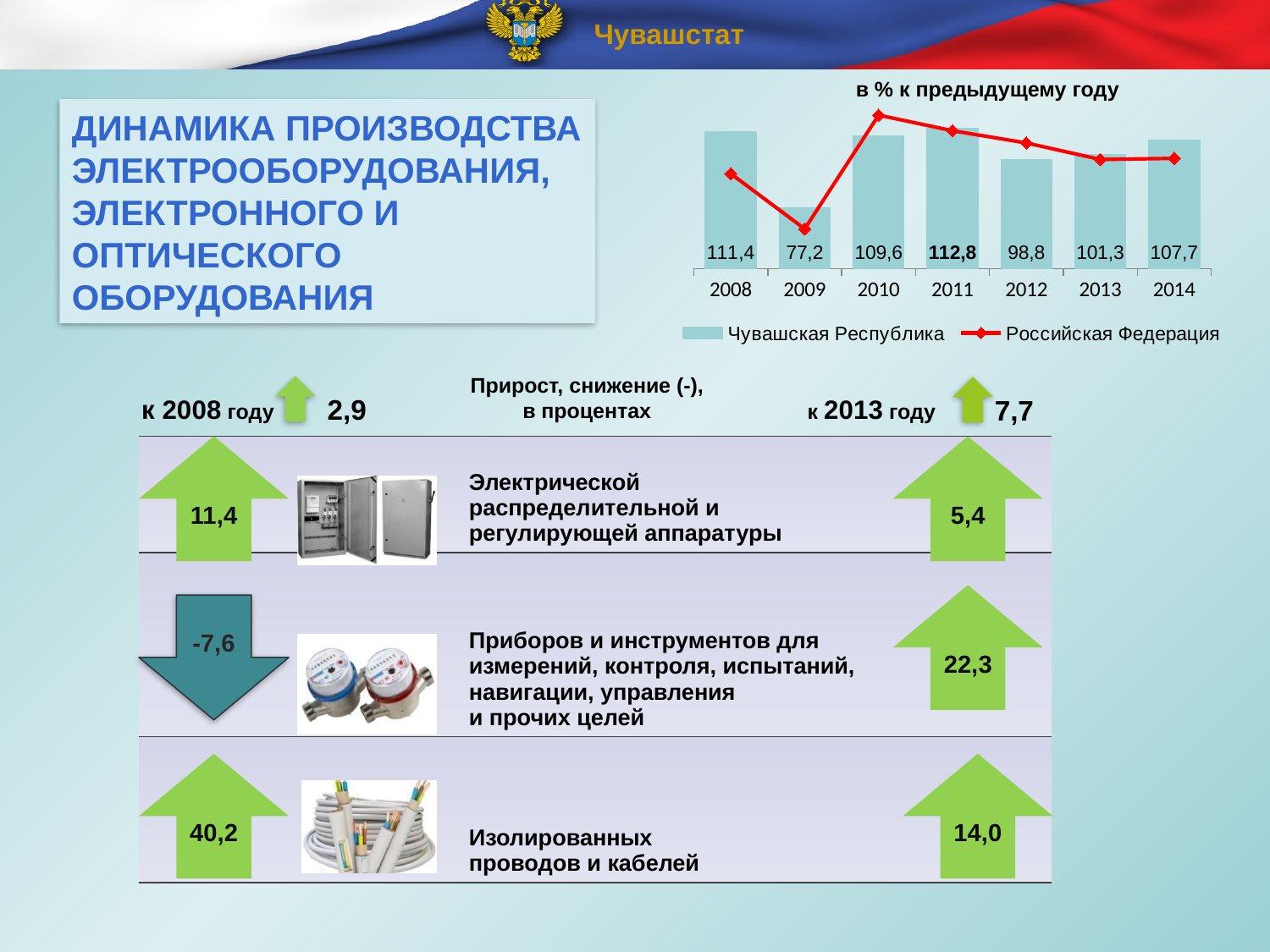
What kind of chart is shown on the slide? Bar chart with a line overlay Which year has the larger value for Чувашская Республика, 2010 or 2012? 2010 In which year is the value for Чувашская Республика the lowest? 2009 How many years are shown on the x axis of the chart? 7 In which year is the value for Чувашская Республика the highest? 2011 What is the difference between the Чувашская Республика values for 2014 and 2013? 6,4 How many series does the chart legend list? 2 What is the difference between the Чувашская Республика values for 2008 and 2009? 34,2 What is the value for Чувашская Республика in 2009? 77,2 What is the value for Чувашская Республика in 2011? 112,8 Does the value for Чувашская Республика rise or fall from 2008 to 2009? Fall What is the value for Чувашская Республика in 2014? 107,7